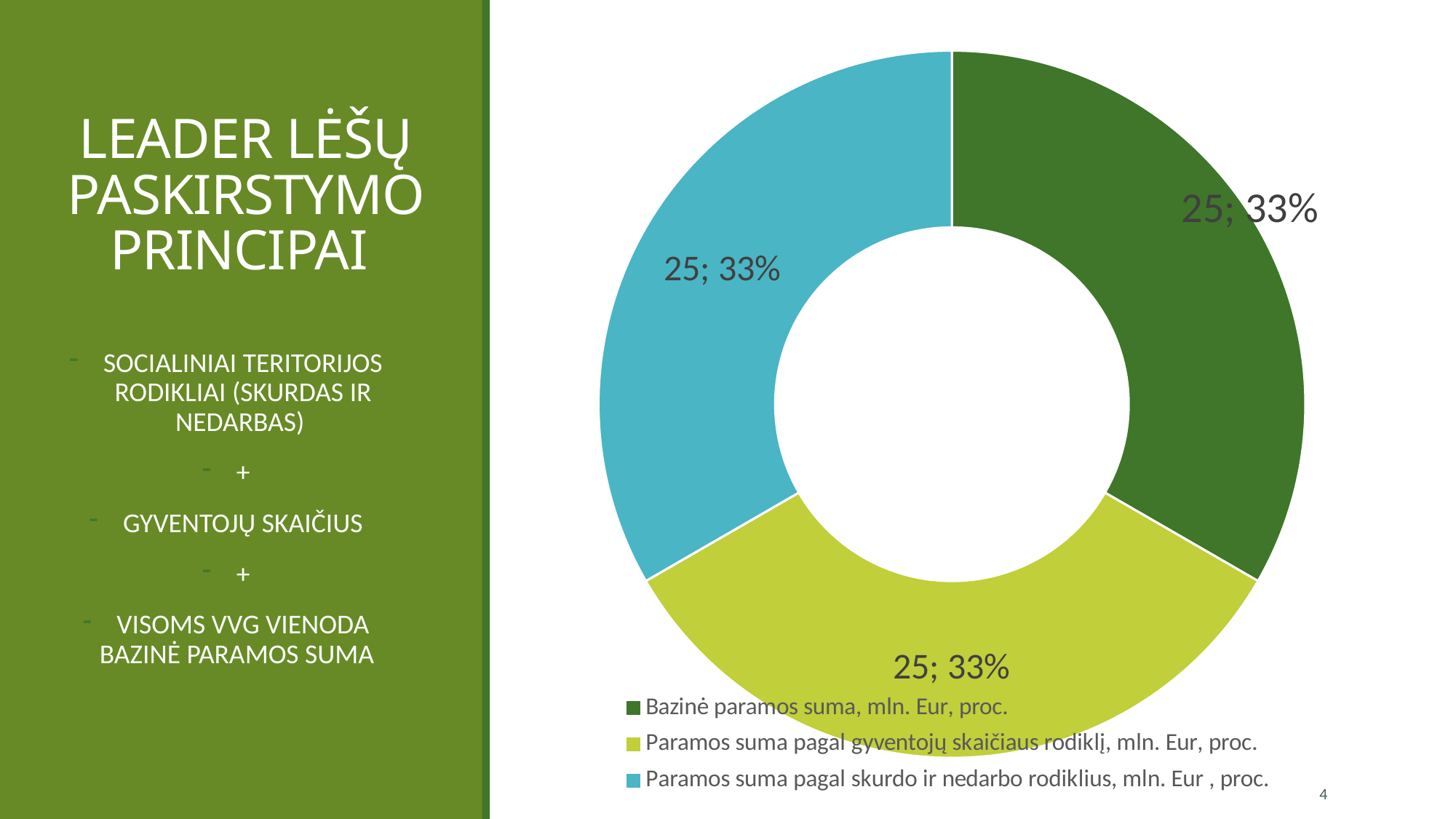
What value is shown for "Paramos suma pagal skurdo ir nedarbo rodiklius, mln. Eur , proc."? 25; 33% Which legend entry is shown in dark green? Bazinė paramos suma, mln. Eur, proc. How many slices does the doughnut chart have? 3 What is the difference between the value for "Bazinė paramos suma" and the value for "Paramos suma pagal gyventojų skaičiaus rodiklį"? 0 What value is shown for "Bazinė paramos suma, mln. Eur, proc."? 25; 33% What kind of chart is shown on the slide? Doughnut (pie) chart What share of the doughnut does the "Paramos suma pagal skurdo ir nedarbo rodiklius" slice represent? 33% Which colour represents "Paramos suma pagal skurdo ir nedarbo rodiklius" in the chart? Blue What is the total of the three values (in mln. Eur) shown on the doughnut chart? 75 What share of the doughnut does the "Bazinė paramos suma" slice represent? 33% How many entries does the chart legend list? 3 What value is shown for "Paramos suma pagal gyventojų skaičiaus rodiklį, mln. Eur, proc."? 25; 33%